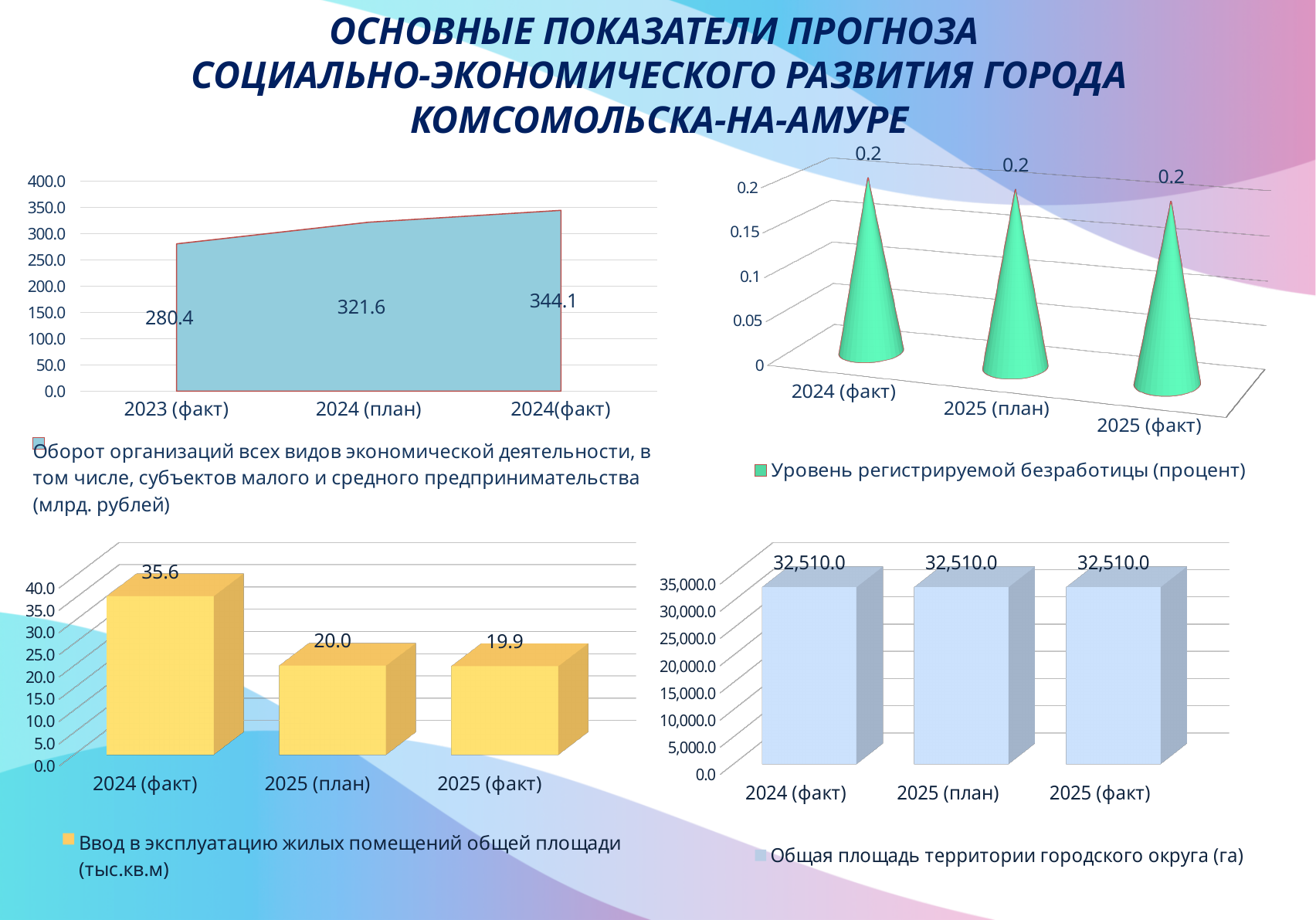
In the top-left chart (Оборот организаций всех видов экономической деятельности), what is the value for 2024 (план)? 321.6 In the top-left chart (Оборот организаций всех видов экономической деятельности), which category has the highest value? 2024(факт) How many categories are shown in the top-right chart (Уровень регистрируемой безработицы)? 3 In the top-left chart (Оборот организаций всех видов экономической деятельности), do the values rise or fall from left to right along the x axis? rise In the bottom-left chart (Ввод в эксплуатацию жилых помещений), which category has the lowest value? 2025 (факт) In the top-left chart (Оборот организаций всех видов экономической деятельности), what is the value for 2023 (факт)? 280.4 In the top-right chart (Уровень регистрируемой безработицы), what is the value for 2025 (план)? 0.2 In the bottom-left chart (Ввод в эксплуатацию жилых помещений), what is the difference between the 2024 (факт) and 2025 (план) values? 15.6 What kind of chart is the bottom-right chart (Общая площадь территории городского округа)? bar chart In the top-left chart (Оборот организаций всех видов экономической деятельности), what is the difference between the 2024(факт) and 2023 (факт) values? 63.7 In the bottom-right chart (Общая площадь территории городского округа), what is the value for 2025 (факт)? 32,510.0 In the bottom-left chart (Ввод в эксплуатацию жилых помещений), what is the value for 2024 (факт)? 35.6